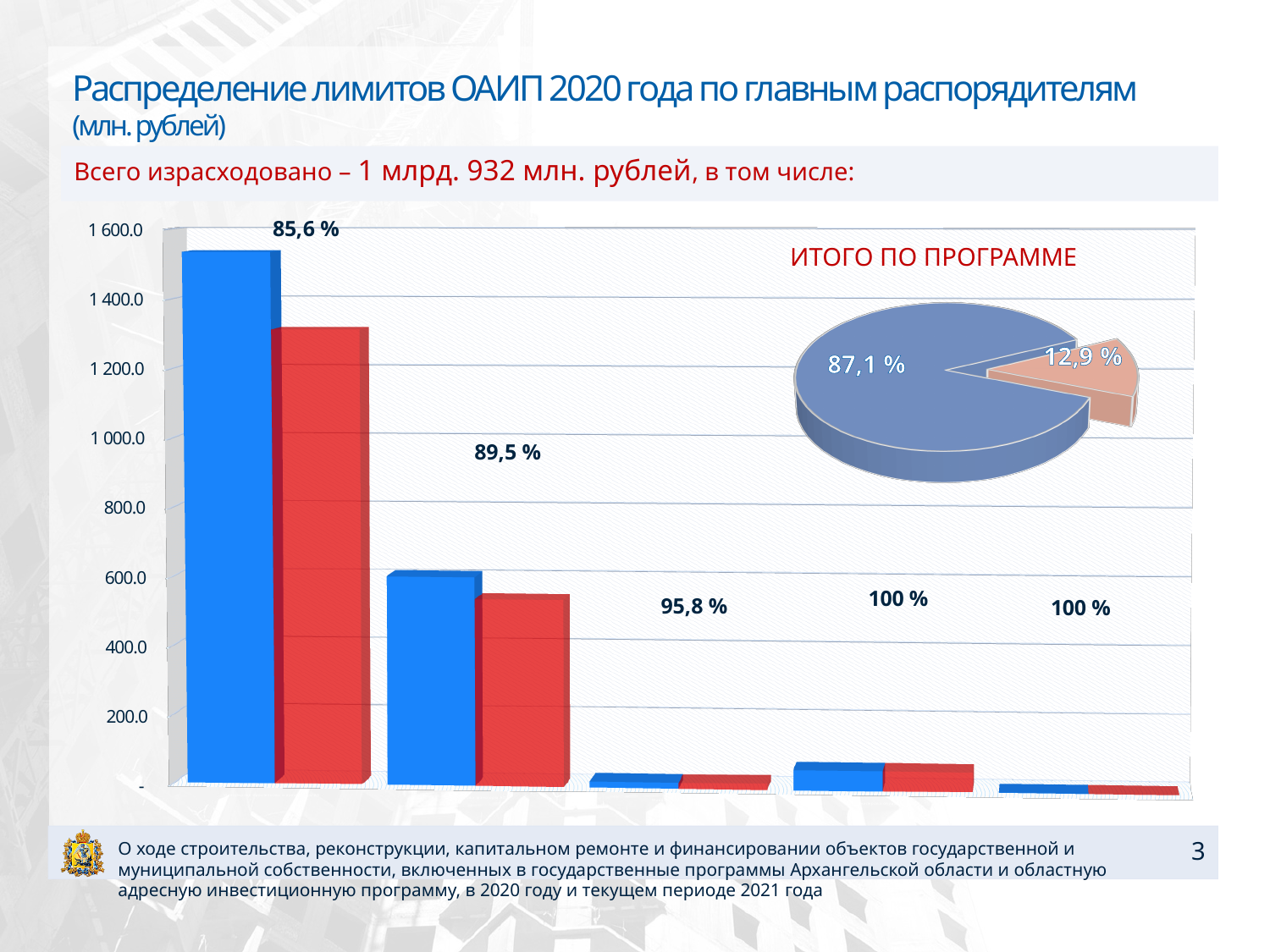
In the bar chart, what percentage label is shown above the first (leftmost) group of bars? 85,6 % In the bar chart, which percentage label is the lowest among those shown above the bar groups? 85,6 % In the bar chart, what percentage label is shown above the second group of bars? 89,5 % In the pie chart "ИТОГО ПО ПРОГРАММЕ", what share does the larger slice have? 87,1 % In the bar chart, is the red bar of the second group greater or less than 600.0? less In the bar chart, is the blue bar of the first (leftmost) group greater or less than 1 400.0? greater In the pie chart "ИТОГО ПО ПРОГРАММЕ", what share does the smaller, pulled-out slice have? 12,9 % What kind of chart is the chart titled "ИТОГО ПО ПРОГРАММЕ"? pie chart How many slices does the pie chart "ИТОГО ПО ПРОГРАММЕ" have? 2 In the bar chart, how many groups of bars are plotted along the x axis? 5 What kind of chart is the large chart on the left side of the slide? bar chart In the bar chart, which group has taller bars: the first group or the second group? the first group